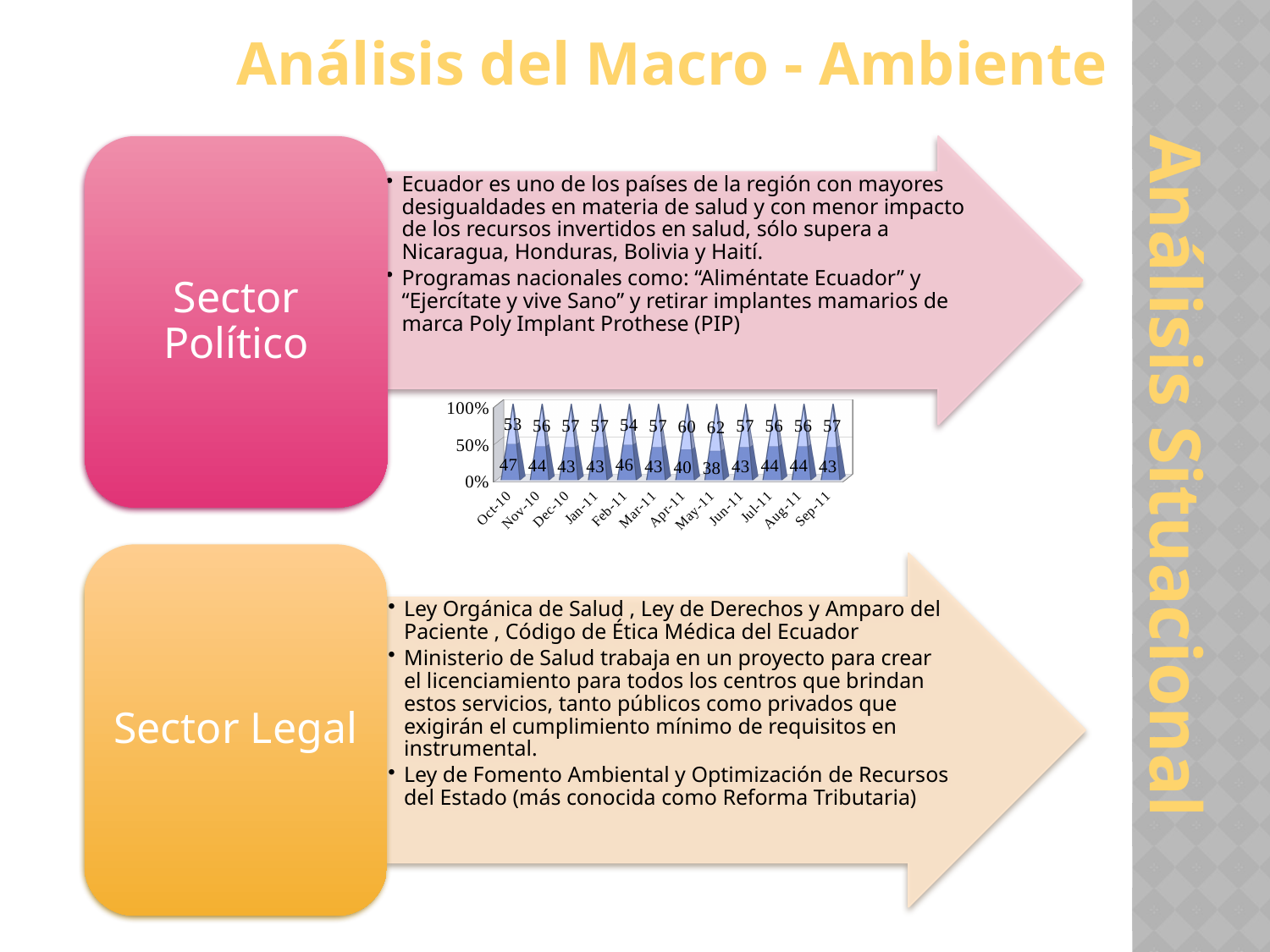
What is the value of the lower segment for Feb-11 in the chart? 46 What kind of chart is shown on the slide? stacked bar chart What is the value of the upper segment for May-11 in the chart? 62 What is the difference between the lower segment values for Oct-10 and May-11? 9 Which month has the highest value for the upper segment in the chart? May-11 What is the value of the lower segment for Oct-10 in the chart? 47 Which month has the larger lower segment value, Feb-11 or Apr-11? Feb-11 Is the lower segment value for May-11 greater or less than 50%? less Which month has the highest value for the lower segment in the chart? Oct-10 What is the total of the two stacked segments for Oct-10? 100 Which month has the lowest value for the lower segment in the chart? May-11 How many months are shown on the x axis of the chart? 12